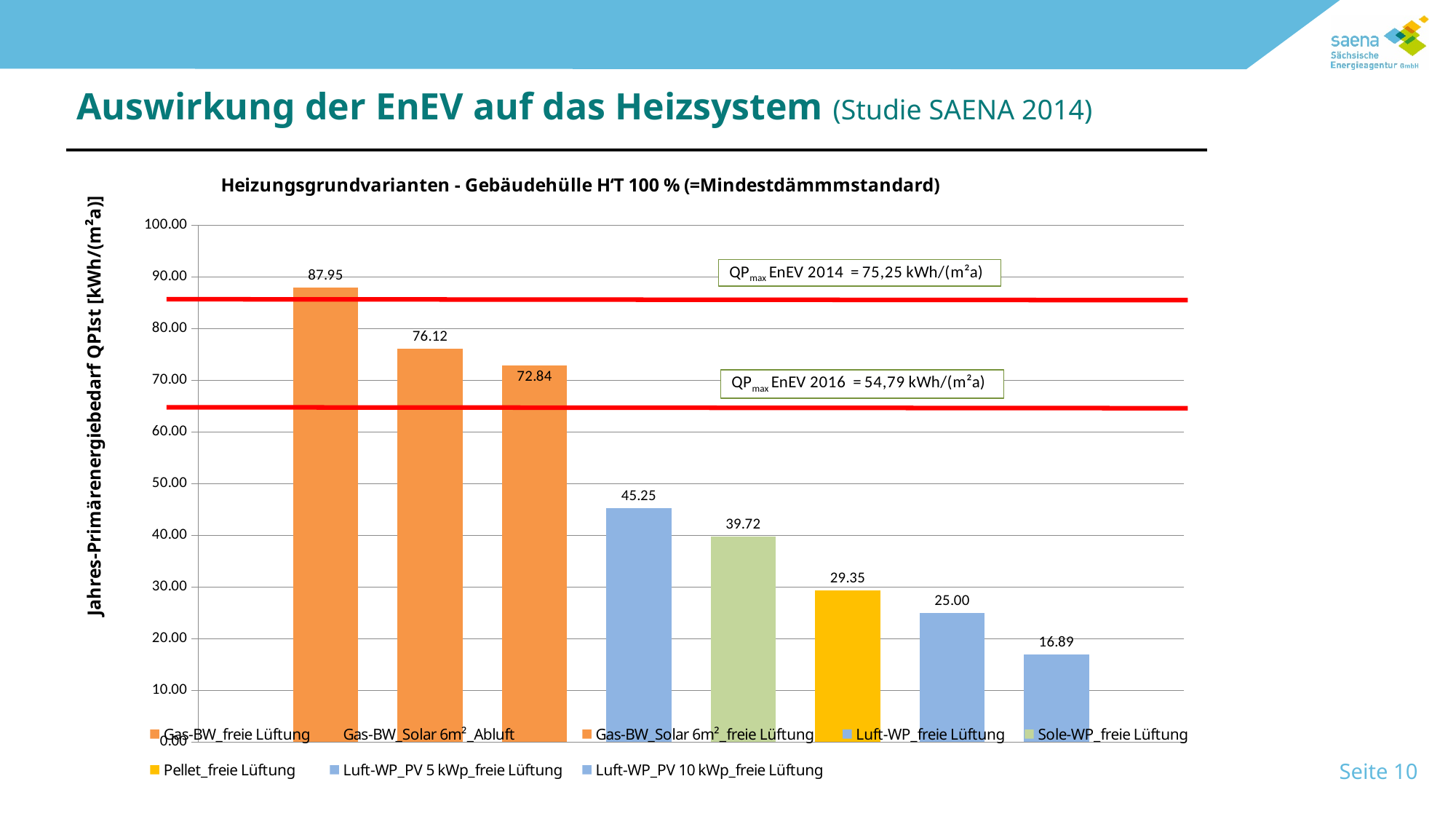
What is the difference between the values for Gas-BW_freie Lüftung and Gas-BW_Solar 6m²_Abluft? 11.83 How many bars are plotted in the chart? 8 What is the value for Sole-WP_freie Lüftung? 39.72 What is the value for Gas-BW_freie Lüftung? 87.95 Which is larger, the value for Luft-WP_freie Lüftung or the value for Sole-WP_freie Lüftung? Luft-WP_freie Lüftung How many entries does the legend list? 8 What kind of chart is shown on the slide? Bar chart What is the value for Luft-WP_PV 10 kWp_freie Lüftung? 16.89 What is the value for Pellet_freie Lüftung? 29.35 Which heating variant has the lowest value? Luft-WP_PV 10 kWp_freie Lüftung Which heating variant has the highest value? Gas-BW_freie Lüftung What is the title of the chart? Heizungsgrundvarianten - Gebäudehülle H'T 100 % (=Mindestdämmmstandard)